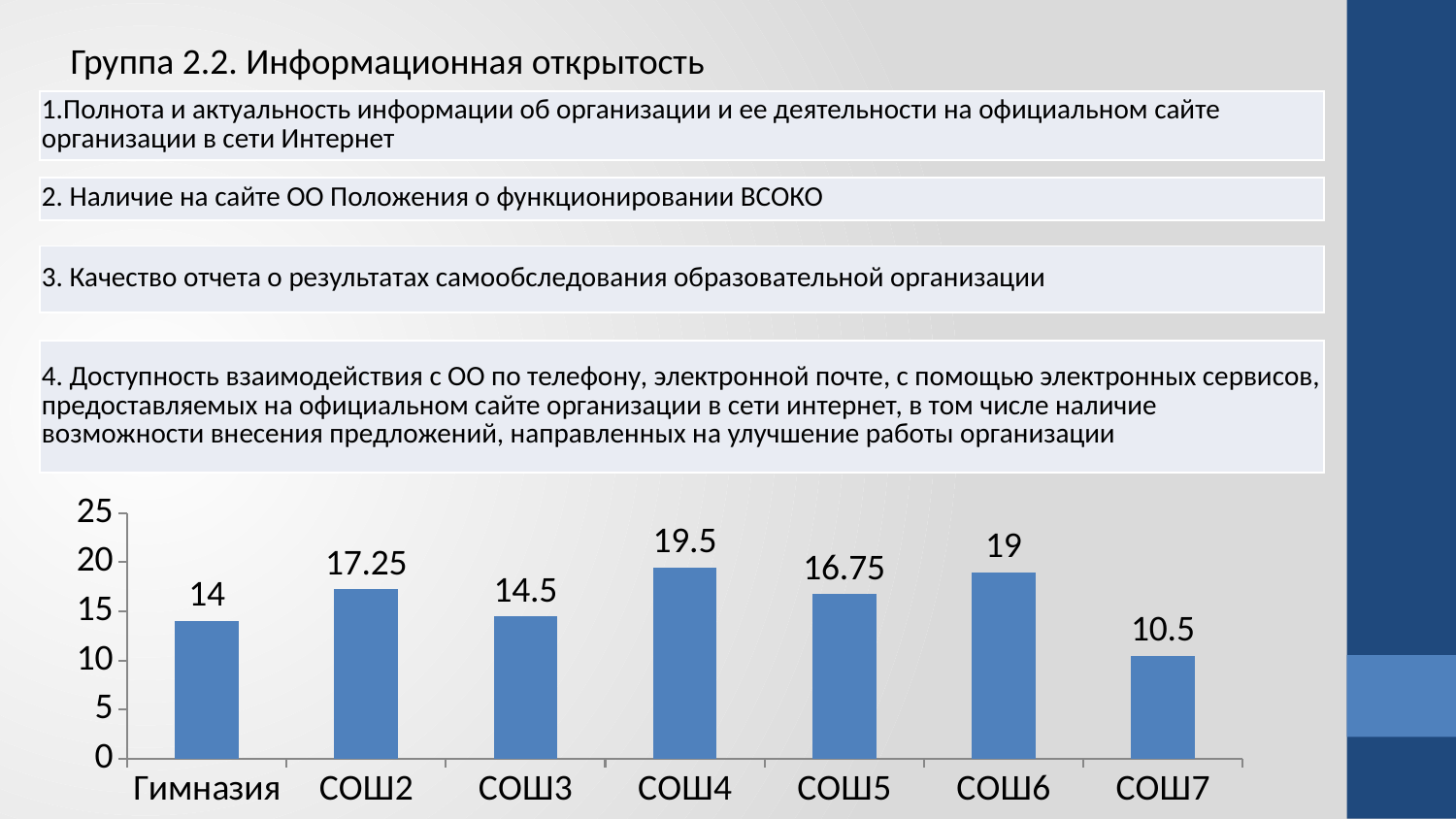
What is the value for СОШ4? 19.5 What kind of chart is shown on the slide? bar chart What is the maximum value shown on the vertical axis? 25 What is the difference between the values for СОШ2 and СОШ3? 2.75 Which category has the highest value? СОШ4 Which is larger, the value for СОШ2 or the value for СОШ5? СОШ2 What is the value for Гимназия? 14 Is the value for СОШ7 greater or less than 15? less What is the difference between the values for СОШ6 and СОШ7? 8.5 Which category has the lowest value? СОШ7 What is the value for СОШ5? 16.75 How many categories are shown on the x axis? 7